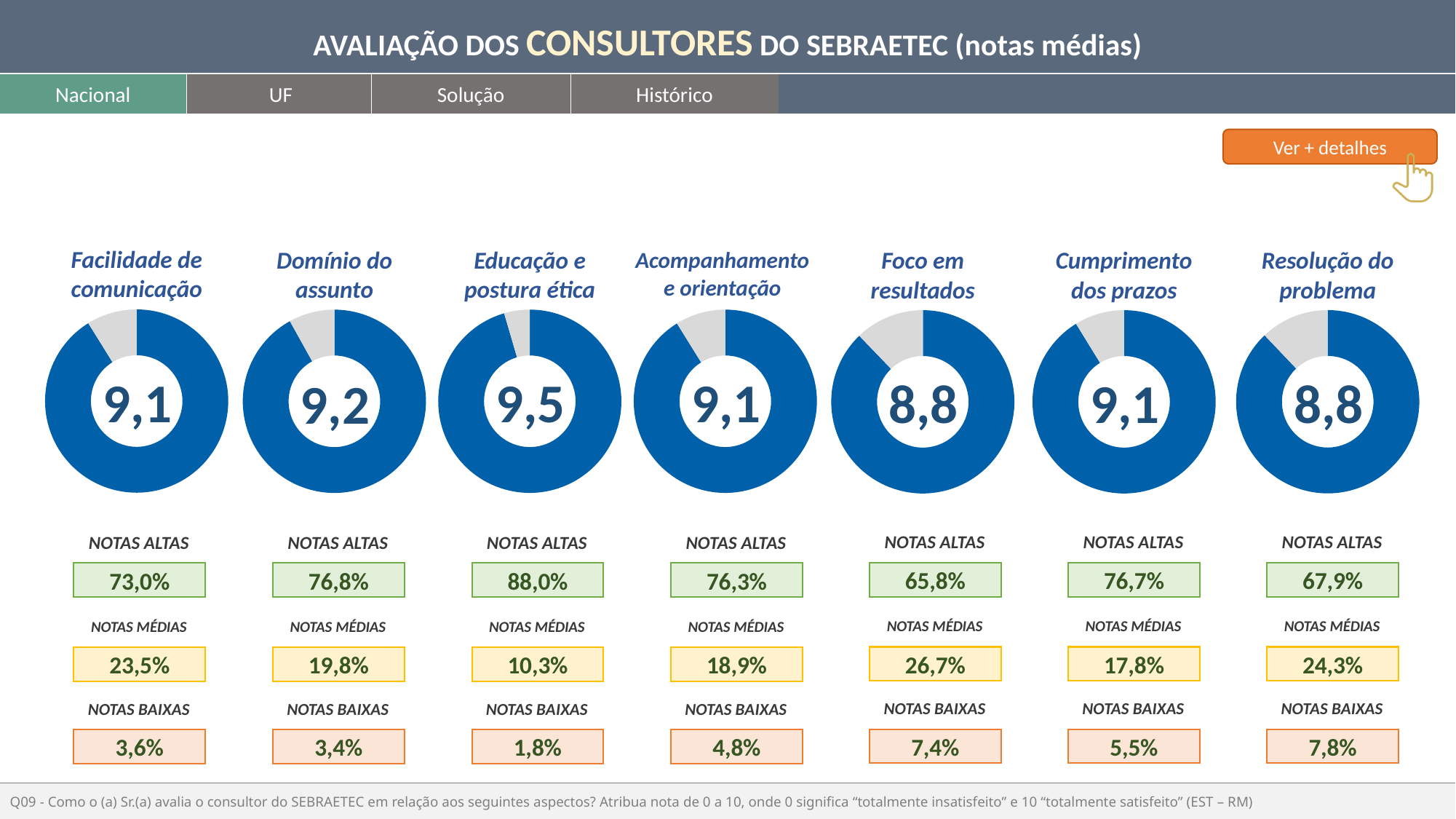
Which aspect has the highest "NOTAS BAIXAS" percentage? Resolução do problema Which aspect has the lowest "NOTAS ALTAS" percentage? Foco em resultados What is the average score shown in the donut chart for "Foco em resultados"? 8,8 Which has a higher average score: "Domínio do assunto" or "Facilidade de comunicação"? Domínio do assunto What is the "NOTAS ALTAS" percentage for "Cumprimento dos prazos"? 76,7% Which aspect has the highest average score among the seven donut charts? Educação e postura ética What is the "NOTAS MÉDIAS" percentage for "Acompanhamento e orientação"? 18,9% What is the average score shown in the donut chart for "Educação e postura ética"? 9,5 What is the difference between the average score for "Domínio do assunto" and the average score for "Resolução do problema"? 0,4 What is the difference between the "NOTAS ALTAS" percentage for "Educação e postura ética" and for "Facilidade de comunicação"? 15,0% How many donut charts are shown on the slide? 7 What kind of chart is used to display the average score for each aspect? Donut chart